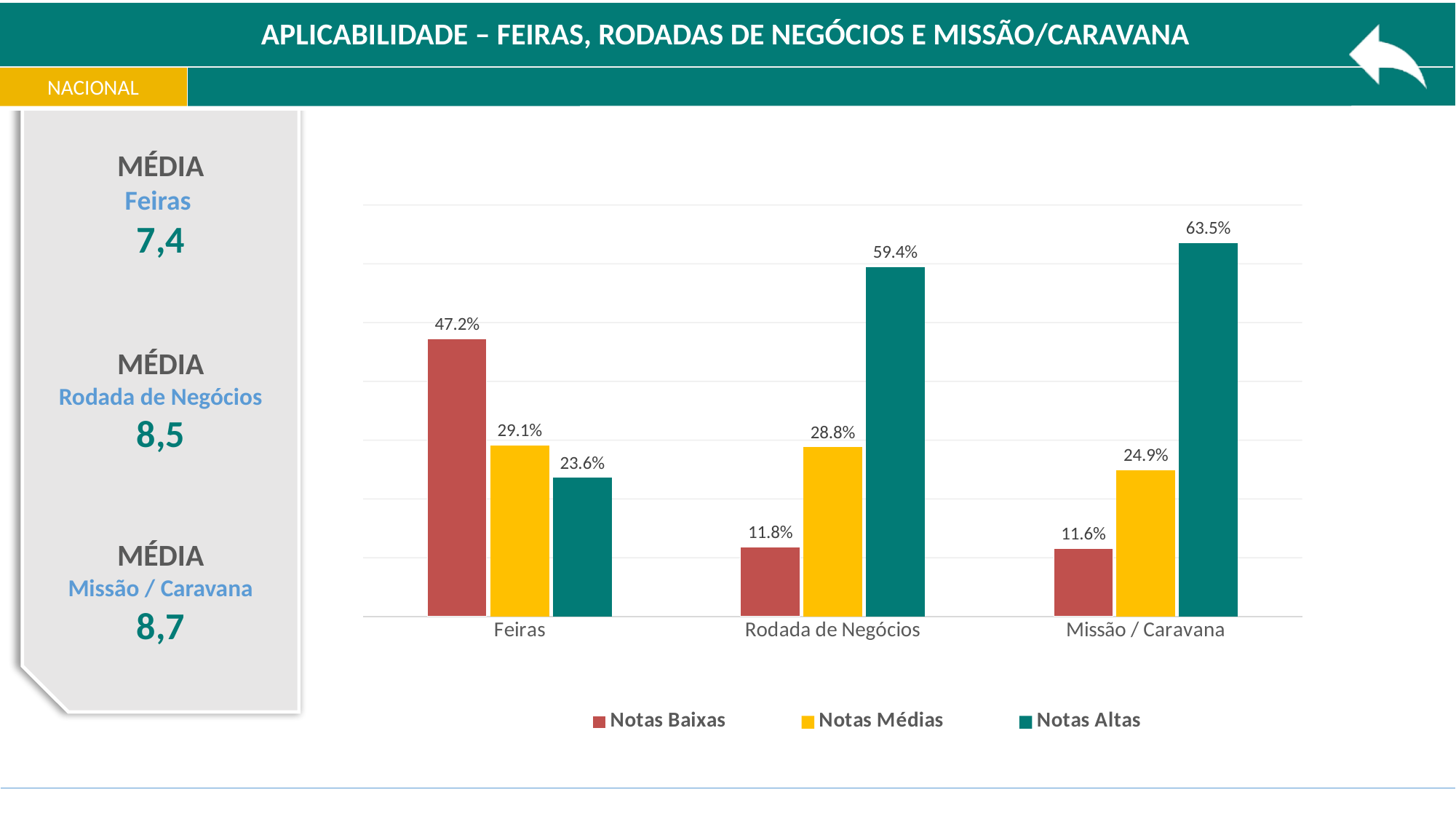
What is the value of Notas Altas for Feiras? 23.6% Which category has the lowest Notas Baixas value? Missão / Caravana What kind of chart is shown on the slide? Bar chart How many categories are shown on the x axis? 3 What is the difference between Notas Altas for Rodada de Negócios and Notas Altas for Feiras? 35.8% How many series does the legend list? 3 What is the value of Notas Altas for Missão / Caravana? 63.5% What is the value of Notas Baixas for Feiras? 47.2% What is the value of Notas Médias for Rodada de Negócios? 28.8% Which is larger: Notas Médias for Feiras or Notas Médias for Missão / Caravana? Notas Médias for Feiras Which category has the highest Notas Altas value? Missão / Caravana Which colour represents Notas Altas in the legend? Teal (green)